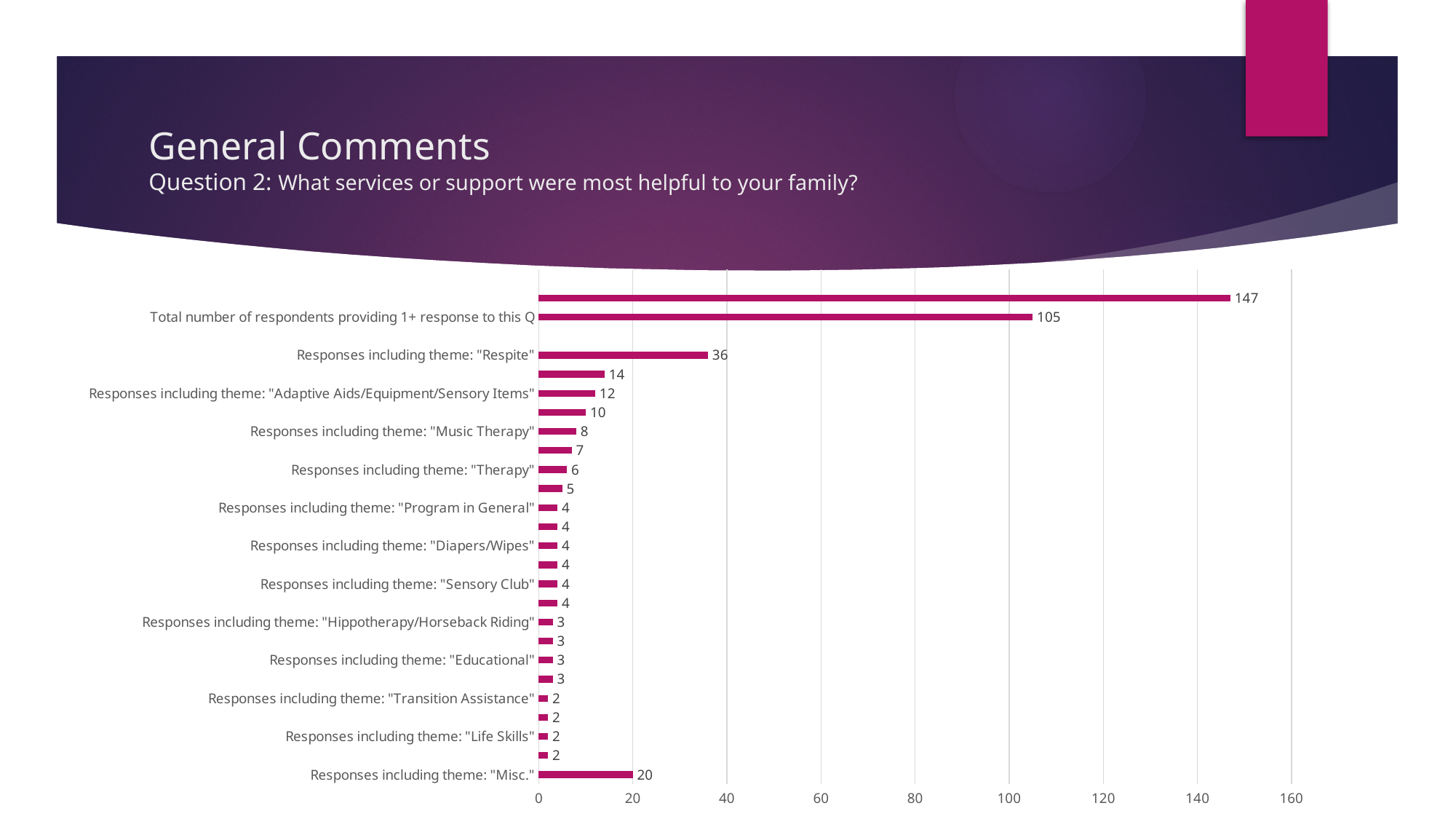
What is the difference between the Total number of respondents providing 1+ response to this Q and Responses including theme: "Respite"? 69 What is the value for Total number of respondents providing 1+ response to this Q? 105 What is the value for Responses including theme: "Music Therapy"? 8 What question does the chart on the slide relate to? Question 2: What services or support were most helpful to your family? What is the difference between the values for Responses including theme: "Respite" and Responses including theme: "Misc."? 16 What kind of chart is shown on the slide? Bar chart What is the value for Responses including theme: "Adaptive Aids/Equipment/Sensory Items"? 12 What is the value for Responses including theme: "Life Skills"? 2 Which is larger: the value for Responses including theme: "Respite" or Responses including theme: "Misc."? Responses including theme: "Respite" What is the value for Responses including theme: "Respite"? 36 Which is larger: the value for Responses including theme: "Music Therapy" or Responses including theme: "Therapy"? Responses including theme: "Music Therapy" What is the value for Responses including theme: "Misc."? 20